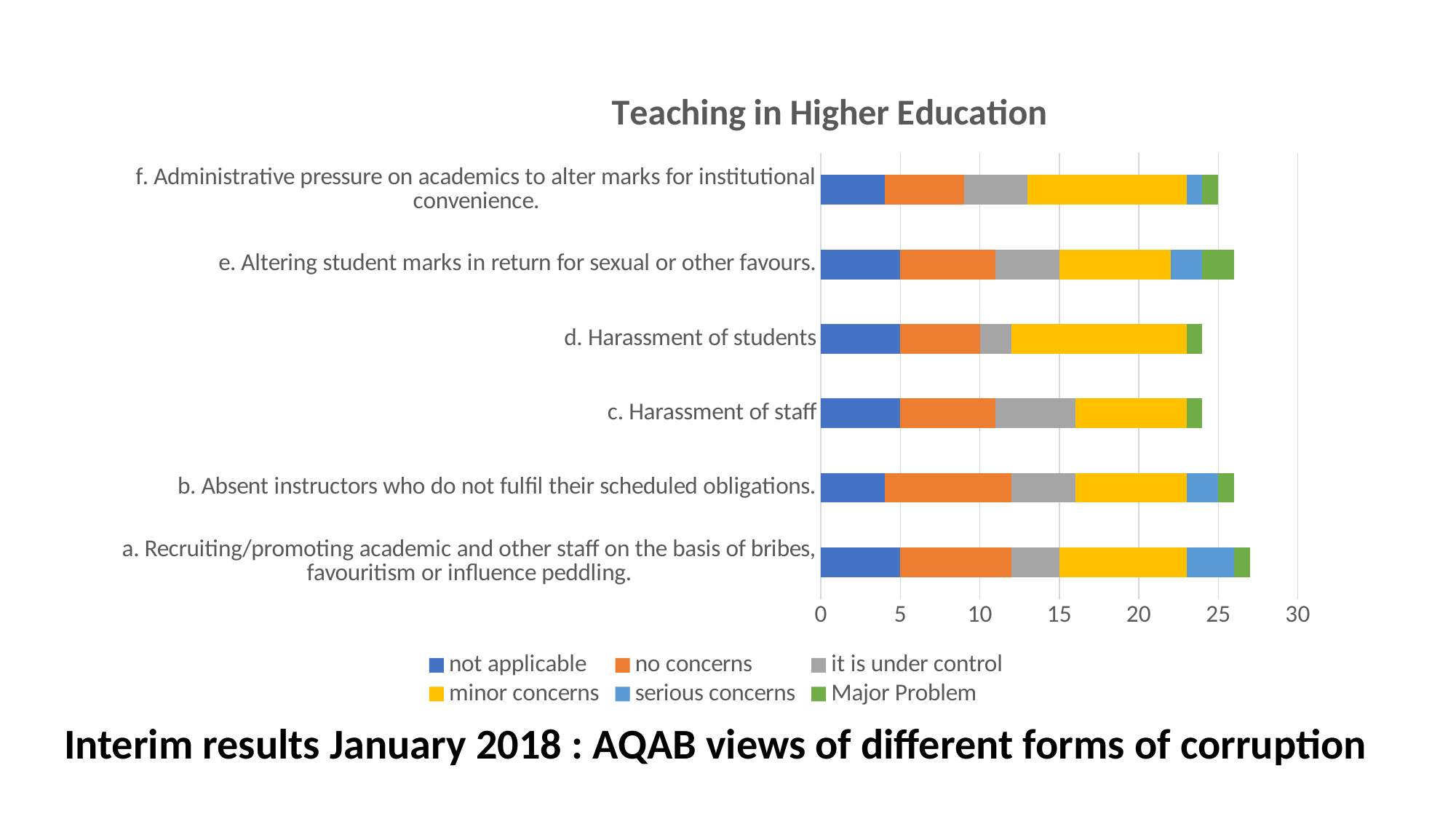
Is the total length of the bar for 'c. Harassment of staff' greater or less than 20? greater Which category has the larger 'no concerns' segment: 'b. Absent instructors who do not fulfil their scheduled obligations.' or 'd. Harassment of students'? b. Absent instructors who do not fulfil their scheduled obligations. What kind of chart is shown on the slide? Stacked bar chart How many series does the legend list? 6 Is the 'no concerns' segment for 'b. Absent instructors who do not fulfil their scheduled obligations.' greater or less than 5? greater Which colour represents the 'minor concerns' series? Yellow What is the title of the chart? Teaching in Higher Education Is the total length of the bar for 'a. Recruiting/promoting academic and other staff on the basis of bribes, favouritism or influence peddling.' greater or less than 25? greater Which has the longer total bar: 'a. Recruiting/promoting academic and other staff on the basis of bribes, favouritism or influence peddling.' or 'c. Harassment of staff'? a. Recruiting/promoting academic and other staff on the basis of bribes, favouritism or influence peddling. How many categories (forms of corruption) are plotted on the chart? 6 Which category has the larger 'minor concerns' segment: 'd. Harassment of students' or 'c. Harassment of staff'? d. Harassment of students